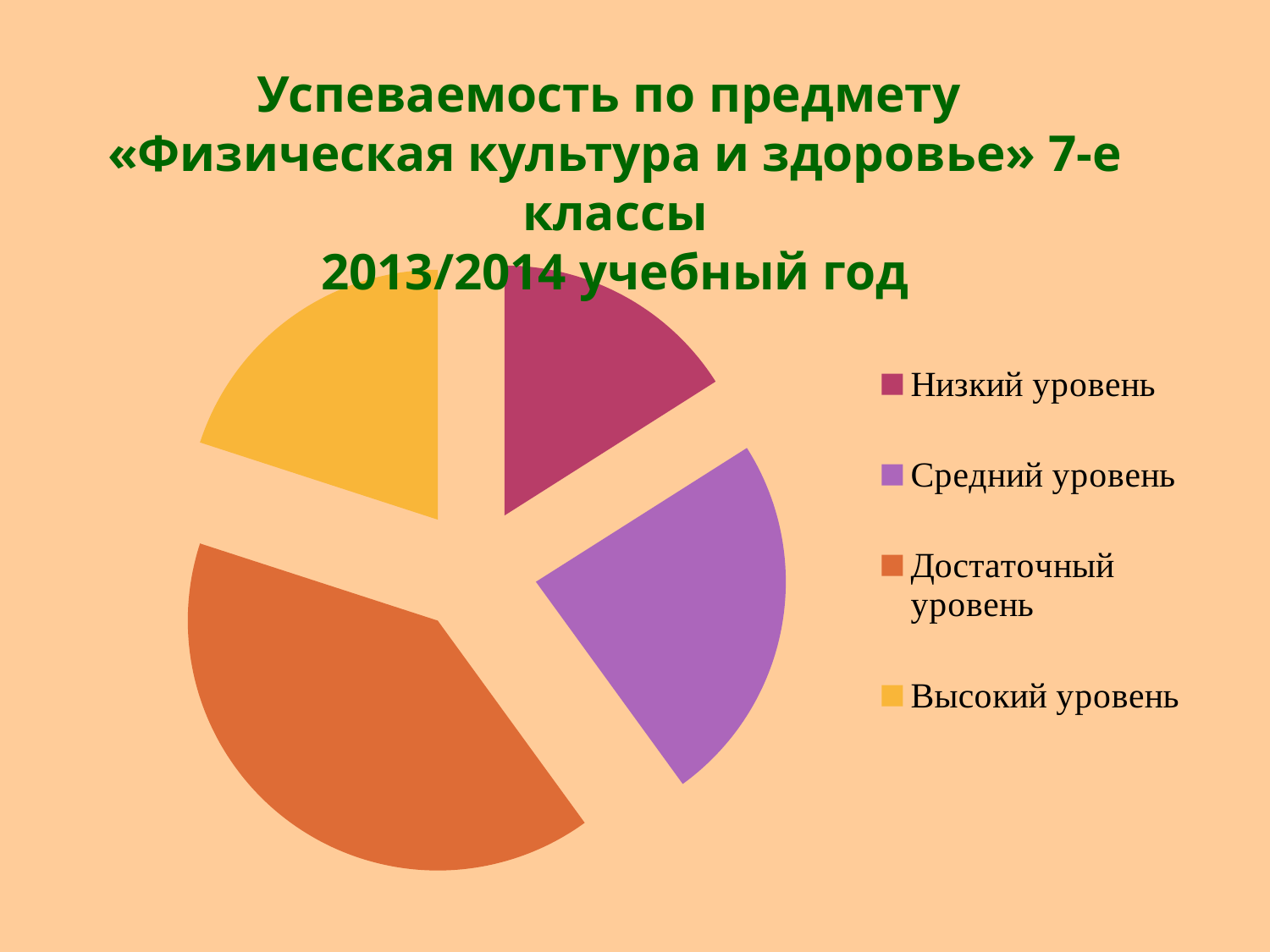
What colour is the slice for Высокий уровень? yellow What kind of chart is shown on the slide? pie chart Which school year does the chart title refer to? 2013/2014 учебный год Which slice is larger: Достаточный уровень or Средний уровень? Достаточный уровень How many slices does the pie chart have? 4 Which category has the smallest slice of the pie? Низкий уровень Which slice is larger: Достаточный уровень or Высокий уровень? Достаточный уровень How many entries does the legend list? 4 Which category has the largest slice of the pie? Достаточный уровень Which slice is larger: Высокий уровень or Низкий уровень? Высокий уровень